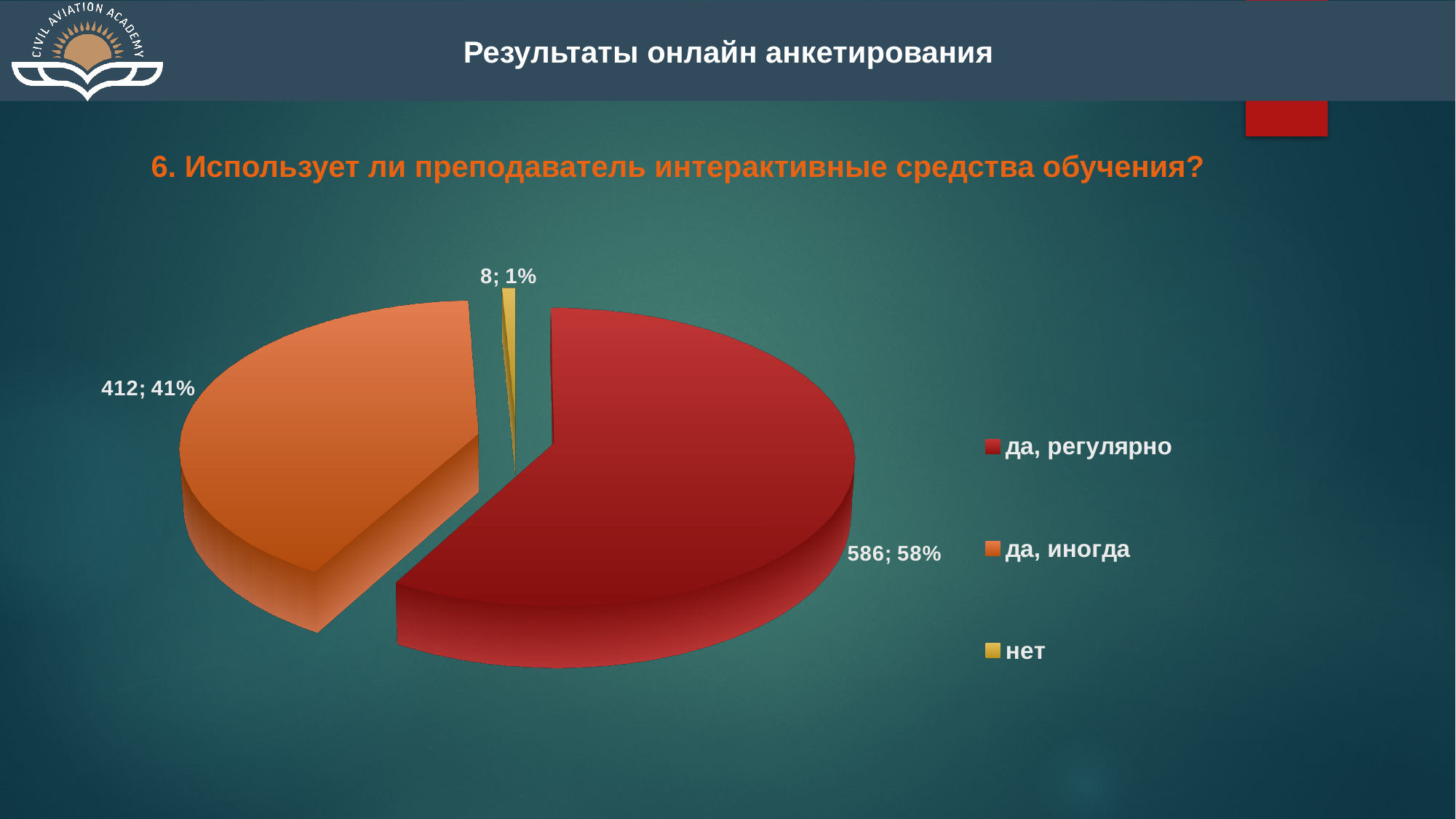
How many categories does the pie chart have? 3 What share of the pie does "да, иногда" represent? 41% What colour is the "нет" slice? yellow How many respondents answered "нет"? 8 What kind of chart is shown on the slide? pie chart What is the difference in respondents between "да, регулярно" and "да, иногда"? 174 How many respondents answered "да, регулярно"? 586 Which has more respondents, "да, иногда" or "нет"? да, иногда What share of the pie does "да, регулярно" represent? 58% Which category has the smallest slice? нет What is the total number of respondents across all slices? 1006 Which category has the largest slice? да, регулярно